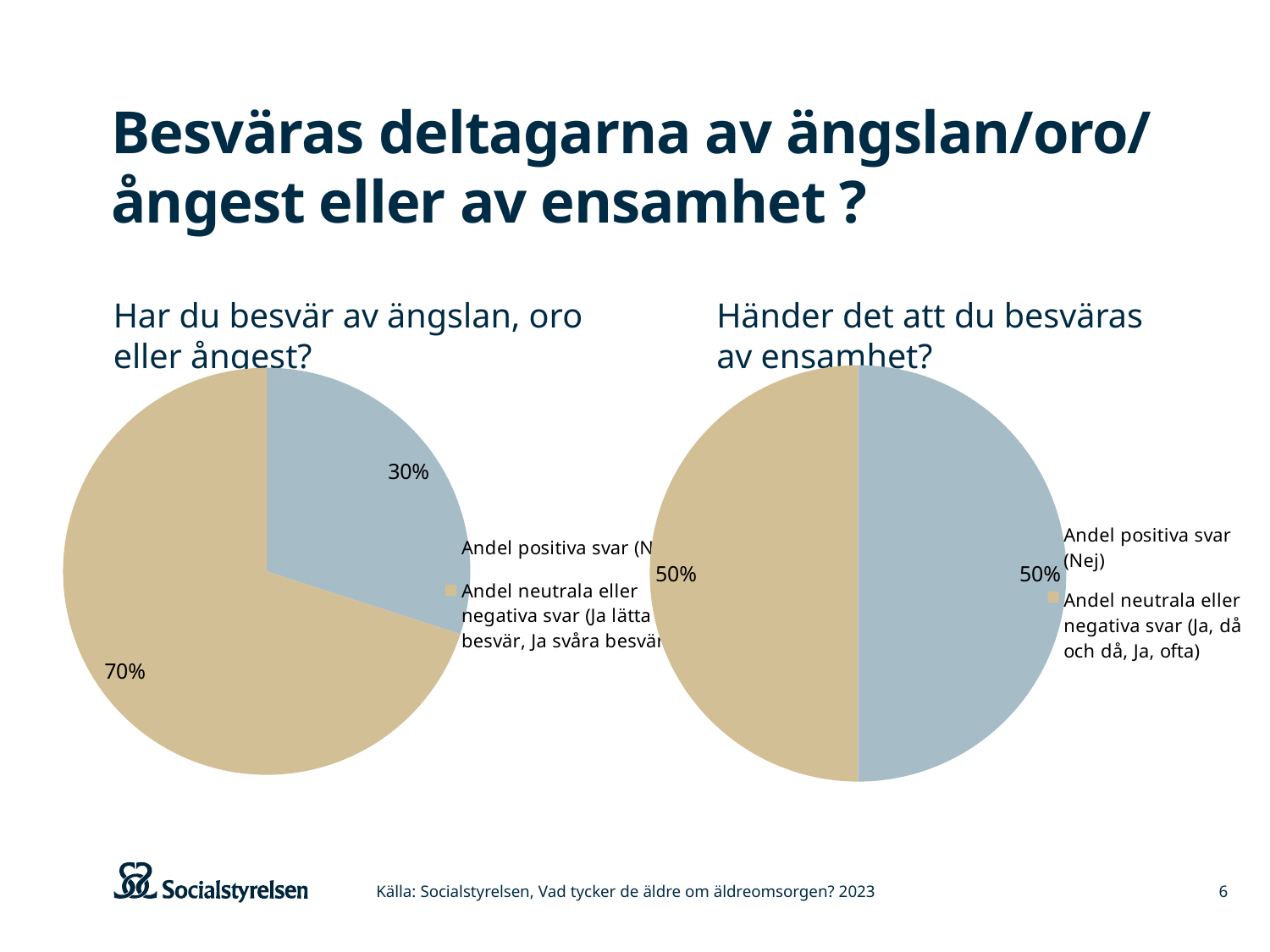
How many slices does the right chart, 'Händer det att du besväras av ensamhet?', have? 2 In the left chart, 'Har du besvär av ängslan, oro eller ångest?', which slice is the largest? Andel neutrala eller negativa svar In the right chart, 'Händer det att du besväras av ensamhet?', what share is labelled for the 'Andel positiva svar (Nej)' slice? 50% What kind of chart is the left chart, 'Har du besvär av ängslan, oro eller ångest?'? Pie chart How many entries does the legend of the right chart, 'Händer det att du besväras av ensamhet?', list? 2 In the right chart, 'Händer det att du besväras av ensamhet?', what share is labelled for the 'Andel neutrala eller negativa svar' slice? 50% In the left chart, 'Har du besvär av ängslan, oro eller ångest?', what share is labelled for the 'Andel positiva svar' slice? 30% What is the title of the right chart? Händer det att du besväras av ensamhet? In the left chart, 'Har du besvär av ängslan, oro eller ångest?', what is the difference in percentage points between the two slices? 40 percentage points In the left chart, 'Har du besvär av ängslan, oro eller ångest?', what share is labelled for the 'Andel neutrala eller negativa svar' slice? 70% Is the 'Andel positiva svar' share in the left chart larger or smaller than the 'Andel positiva svar (Nej)' share in the right chart? Smaller How many pie charts are shown on the slide? 2